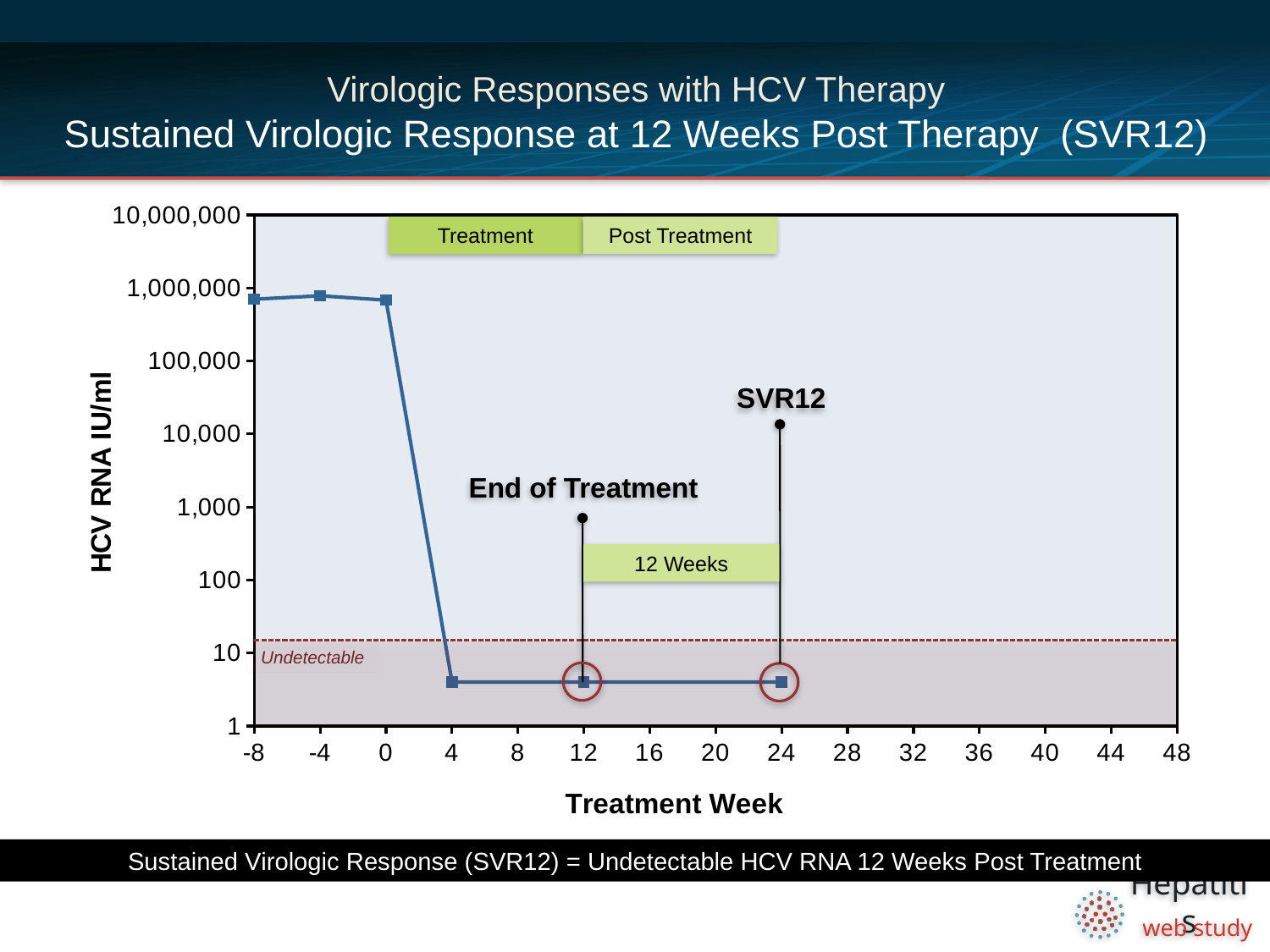
At which treatment week is the point labelled SVR12 located? 24 Is the HCV RNA value at treatment week -8 greater or less than 100,000? greater Is the HCV RNA value at treatment week 0 greater or less than 100,000? greater What is the title of the x axis? Treatment Week Do the HCV RNA values rise or fall between treatment week 0 and treatment week 4? fall How many data points are plotted on the line? 6 Is the HCV RNA value at treatment week 12 greater or less than 10? less What is the title of the y axis? HCV RNA IU/ml Which is larger, the HCV RNA value at week 0 or at week 4? week 0 What kind of chart is shown on the slide? line chart